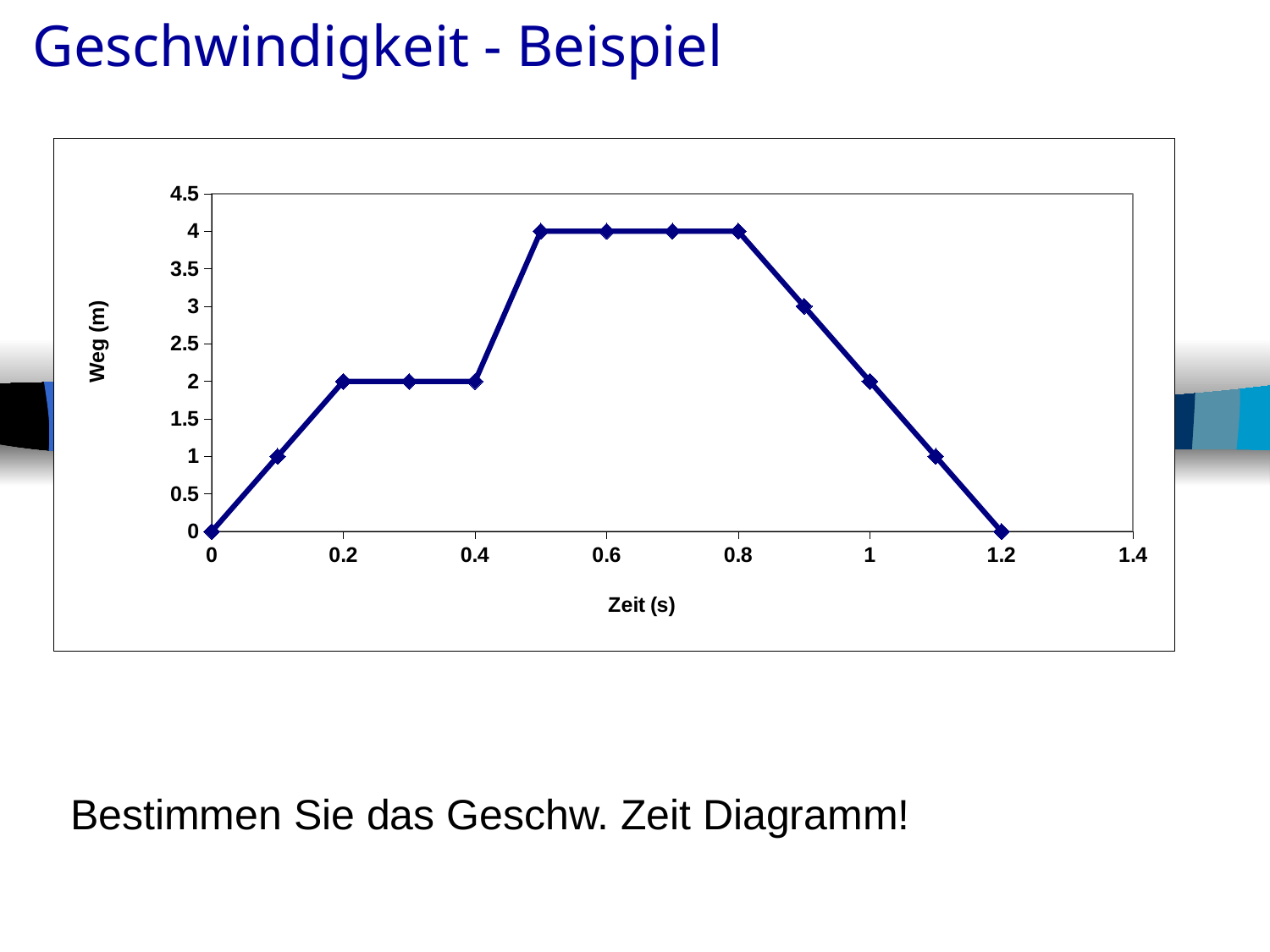
What is the value of Weg (m) at Zeit 1 s? 2 What is the highest value of Weg (m) reached in the chart? 4 What is the value of Weg (m) at Zeit 0.2 s? 2 How many data points are plotted on the line? 13 Which has the larger Weg value: Zeit 0.4 s or Zeit 0.8 s? 0.8 s What is the value of Weg (m) at Zeit 1.2 s? 0 What is the difference between the Weg value at 0.6 s and the Weg value at 0.2 s? 2 What is the value of Weg (m) at Zeit 0.6 s? 4 What is the label of the vertical axis? Weg (m) Does the Weg value rise or fall between Zeit 0 s and 0.2 s? rise What kind of chart is shown on the slide? line chart Does the Weg value rise or fall between Zeit 0.8 s and 1.2 s? fall